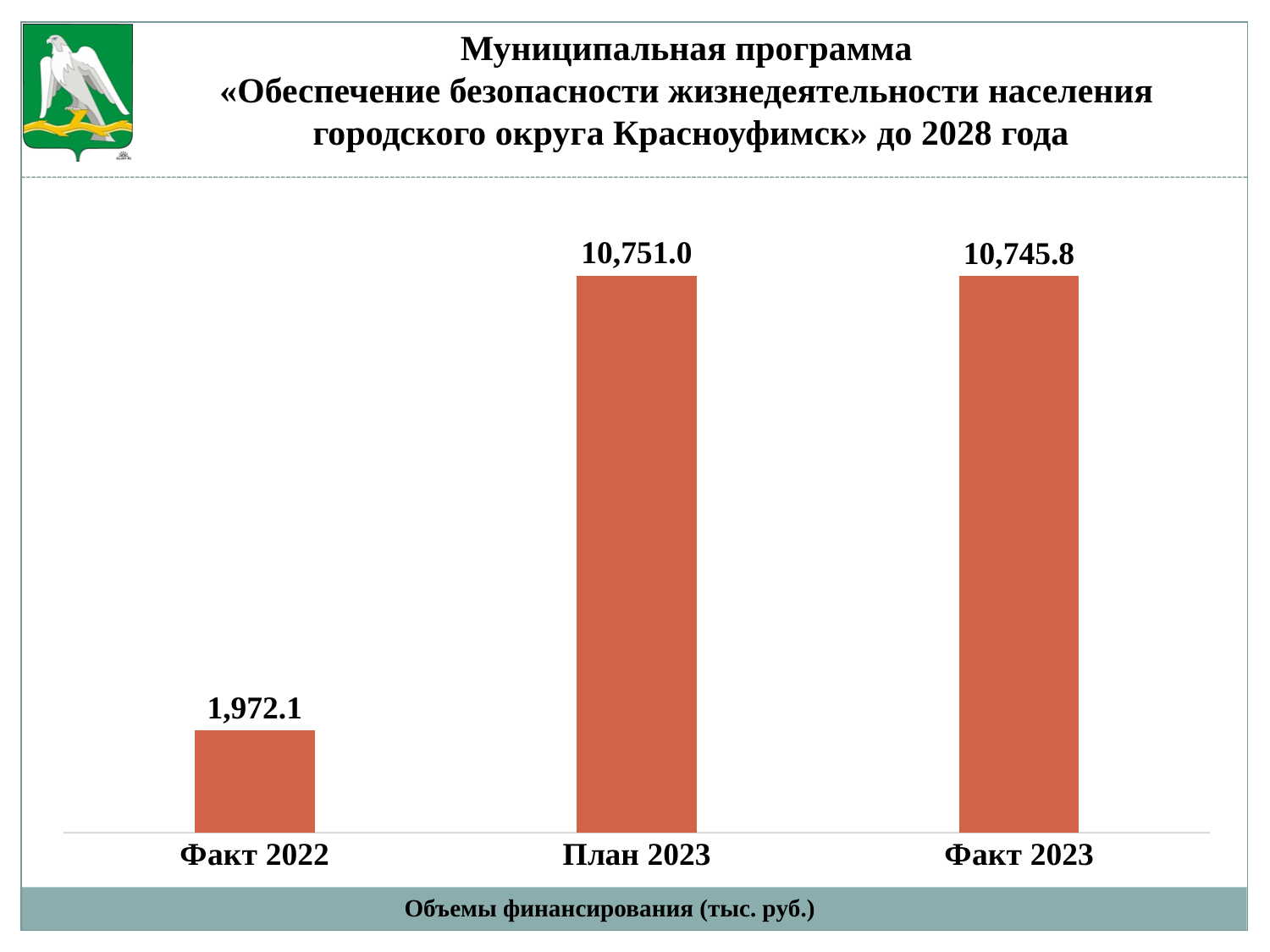
What is the difference between the values for План 2023 and Факт 2023? 5.2 What is the value for Факт 2023? 10,745.8 What is the value for План 2023? 10,751.0 What is the difference between the values for План 2023 and Факт 2022? 8,778.9 Does the value rise or fall from Факт 2022 to План 2023? Rise What colour are the bars in the chart? Orange-red How many categories are shown in the chart? 3 What unit of measurement is stated in the chart caption? тыс. руб. Which is larger, the value for Факт 2022 or the value for Факт 2023? Факт 2023 What kind of chart is shown on the slide? Bar chart Which category has the lowest value? Факт 2022 What is the value for Факт 2022? 1,972.1